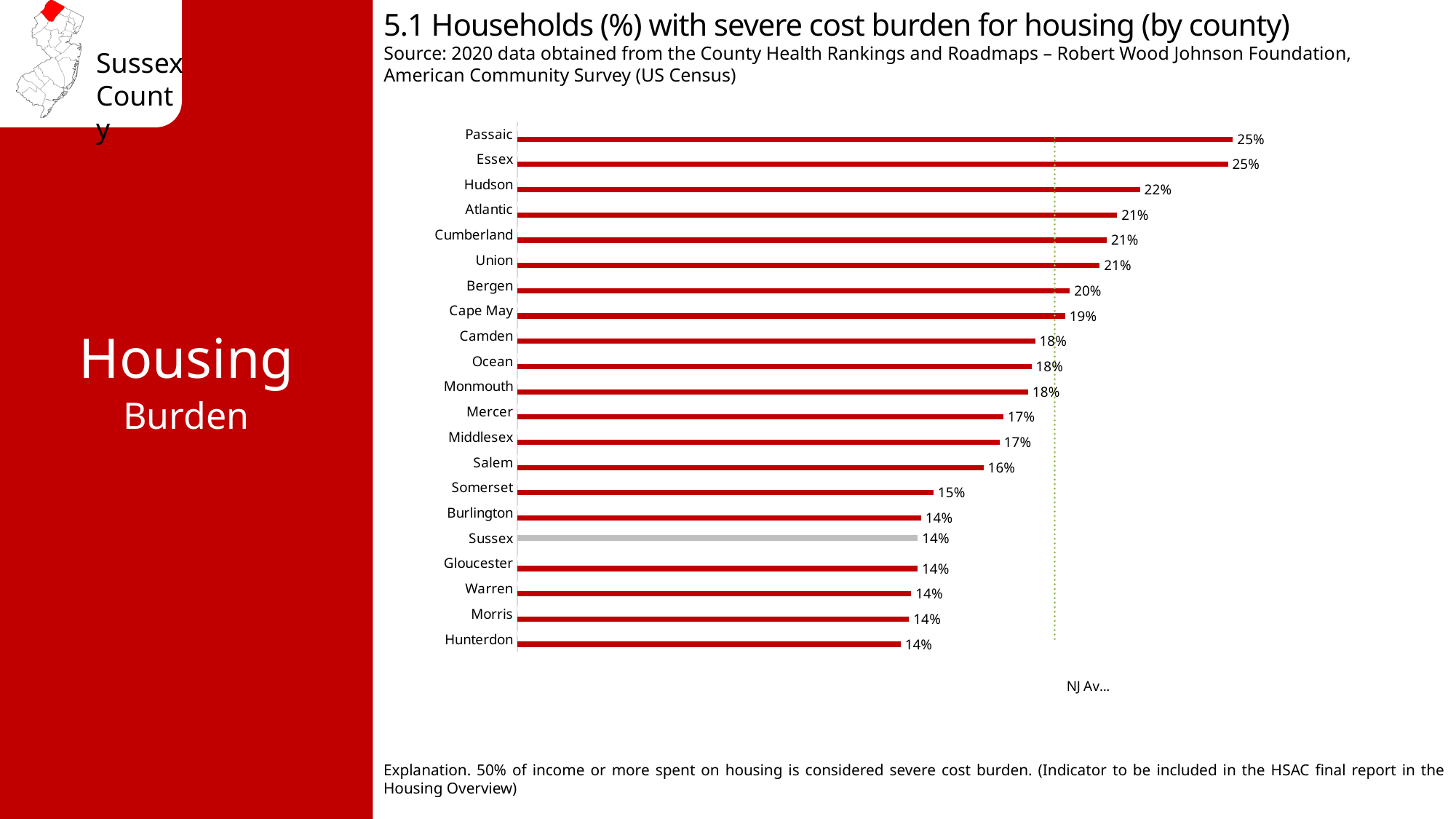
What is the difference between the values for Hudson and Bergen? 2% Which has a larger value, Salem or Somerset? Salem Which county's bar is shown in gray instead of red? Sussex What is the difference between the values for Passaic and Sussex? 11% How many counties are shown in the chart? 21 What is the value for Somerset? 15% What is the value for Sussex? 14% What is the value for Cape May? 19% What is the value for Salem? 16% What is the value for Hudson? 22% What kind of chart is shown on the slide? Bar chart Which has a larger value, Hudson or Bergen? Hudson